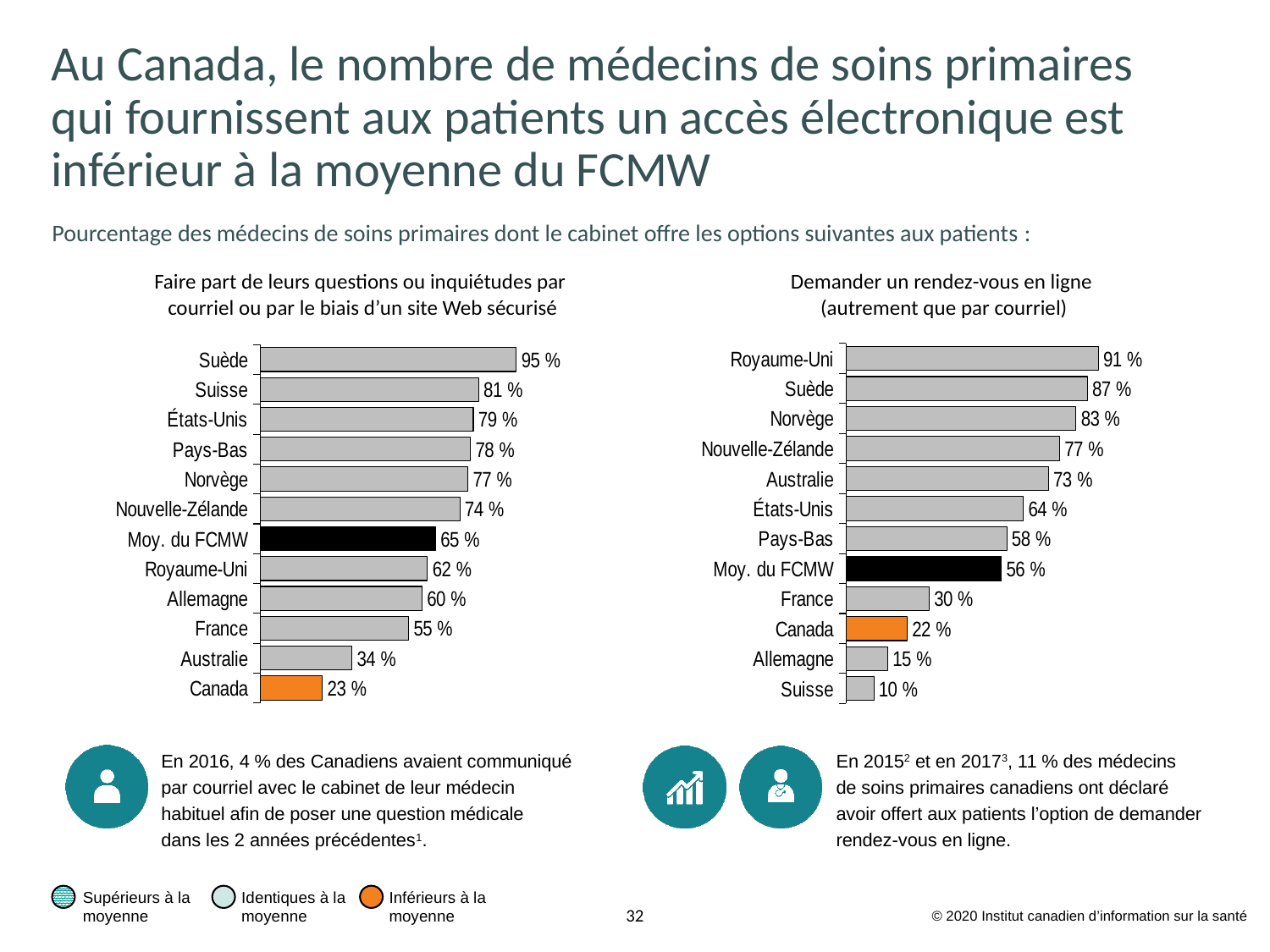
In the left chart (Faire part de leurs questions ou inquiétudes par courriel), what is the value for Canada? 23 % In the left chart (Faire part de leurs questions ou inquiétudes par courriel ou par le biais d'un site Web sécurisé), what is the value for Suède? 95 % What kind of chart is the right chart (Demander un rendez-vous en ligne)? Bar chart In the left chart (Faire part de leurs questions ou inquiétudes par courriel), which country has the lowest value? Canada In the right chart (Demander un rendez-vous en ligne), what colour is the bar for Canada? Orange In the right chart (Demander un rendez-vous en ligne), what is the value for Moy. du FCMW? 56 % In the right chart (Demander un rendez-vous en ligne), which country has the lowest value? Suisse In the right chart (Demander un rendez-vous en ligne), which country has the highest value? Royaume-Uni How many bars are shown in the left chart (Faire part de leurs questions ou inquiétudes par courriel)? 12 In the right chart (Demander un rendez-vous en ligne), what is the difference between Royaume-Uni and Canada? 69 % In the right chart (Demander un rendez-vous en ligne), which is larger, the value for France or the value for Canada? France In the left chart (Faire part de leurs questions ou inquiétudes par courriel), what is the difference between Moy. du FCMW and Canada? 42 %